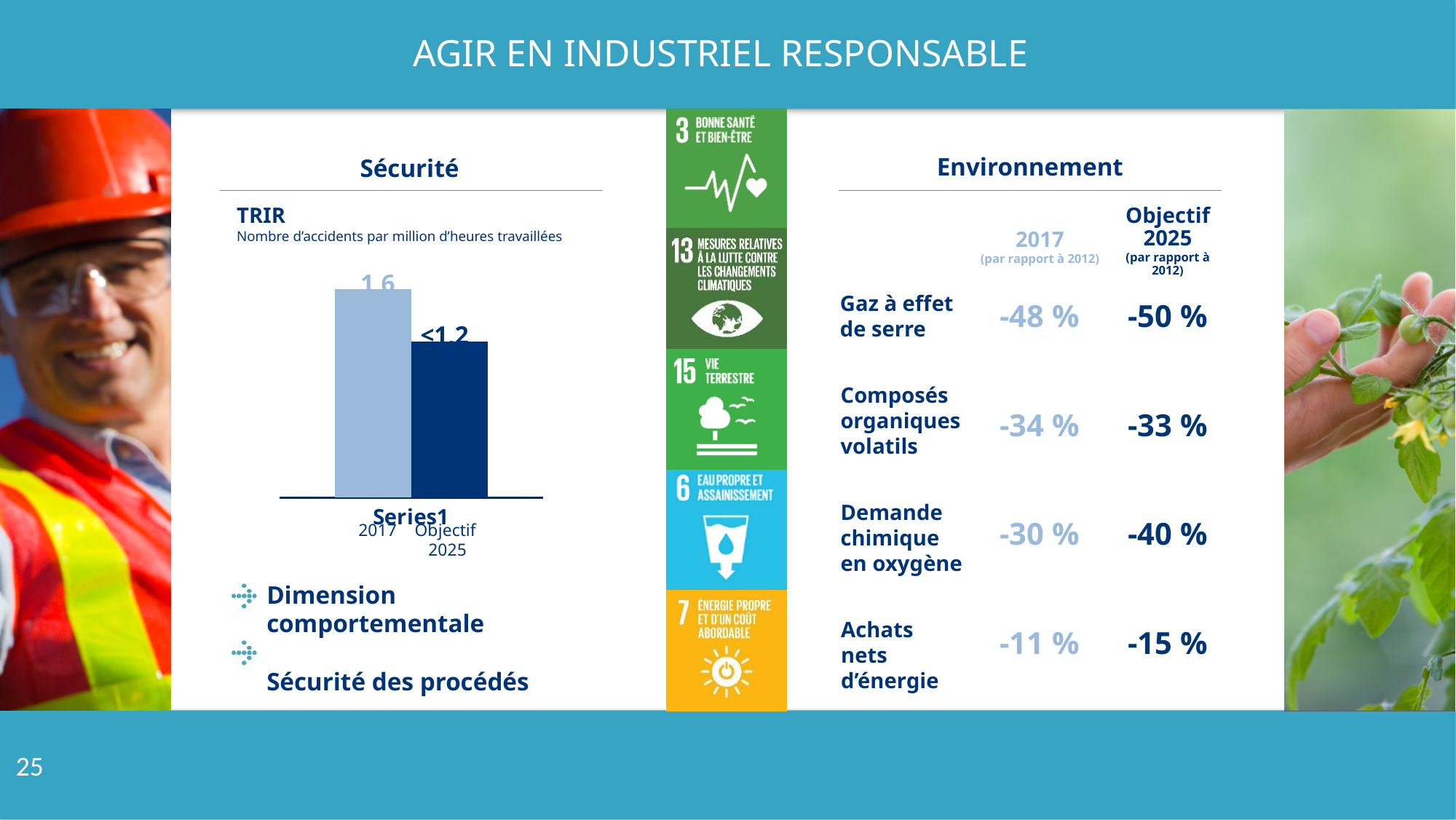
What is the title of the bar chart under the Sécurité heading? TRIR How many bars does the TRIR chart show? 2 Do the values in the TRIR chart rise or fall from 2017 to Objectif 2025? fall What is the TRIR value shown for 2017? 1.6 In the TRIR chart, is the value for 2017 larger or smaller than the value for Objectif 2025? larger Which bar in the TRIR chart is the lowest? Objectif 2025 What is the TRIR value shown for Objectif 2025? <1.2 What kind of chart is shown under the Sécurité heading? bar chart Which bar in the TRIR chart is the highest? 2017 What does the subtitle of the TRIR chart say the values measure? Nombre d'accidents par million d'heures travaillées